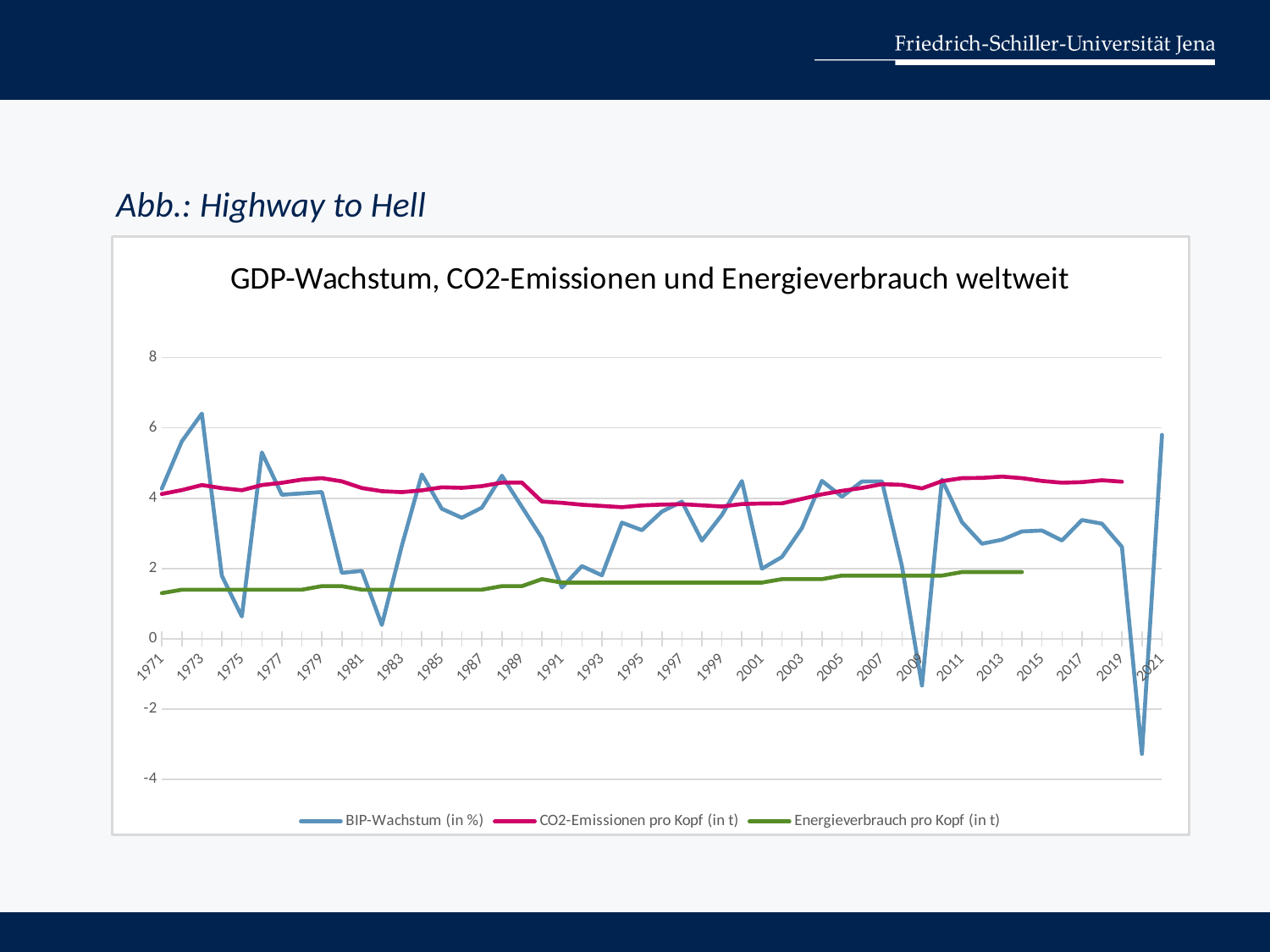
Does Energieverbrauch pro Kopf (in t) rise or fall overall from 1971 to 2013? rise What is the title of the chart? GDP-Wachstum, CO2-Emissionen und Energieverbrauch weltweit Is the value of Energieverbrauch pro Kopf (in t) in 1971 greater or less than 2? less What kind of chart is shown on the slide? line chart How many series does the legend list? 3 Which series is drawn in green? Energieverbrauch pro Kopf (in t) In which year does BIP-Wachstum (in %) reach its lowest value? 2020 In 2001, which is larger: CO2-Emissionen pro Kopf (in t) or Energieverbrauch pro Kopf (in t)? CO2-Emissionen pro Kopf (in t) Is the value of BIP-Wachstum (in %) in 2009 greater or less than 0? less Is the value of BIP-Wachstum (in %) in 2020 greater or less than -2? less